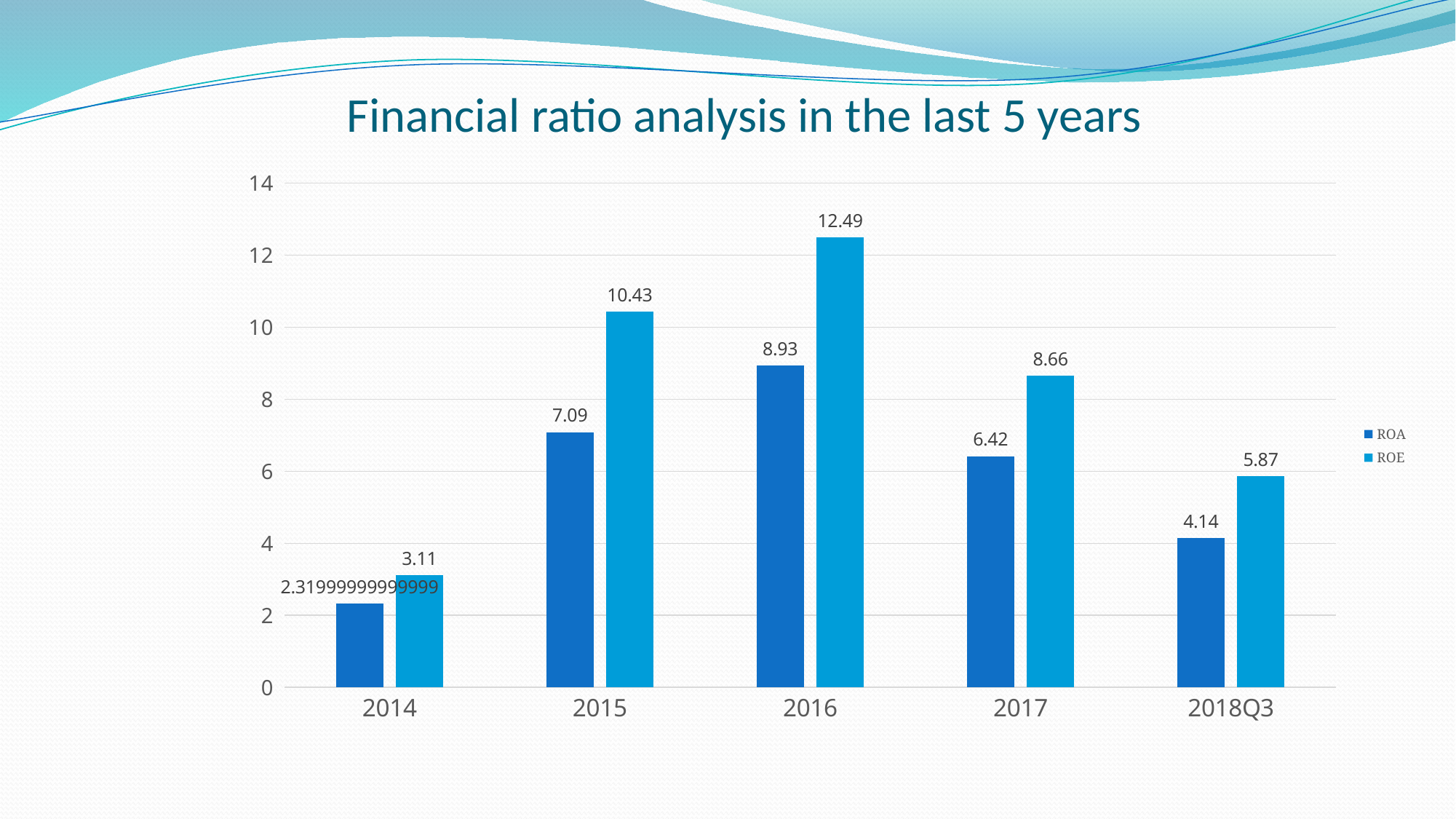
What is the ROE value for 2018Q3? 5.87 Which is larger, the ROA for 2017 or the ROA for 2018Q3? ROA for 2017 What is the ROE value for 2016? 12.49 What kind of chart is shown on the slide? bar chart What is the difference between the ROE values for 2016 and 2015? 2.06 Which year has the highest ROA? 2016 What is the ROA value for 2015? 7.09 What is the difference between ROE and ROA in 2017? 2.24 How many series does the legend list? 2 How many time periods are shown on the x axis? 5 Which year has the lowest ROE? 2014 Is the ROA value for 2014 greater or less than 4? less